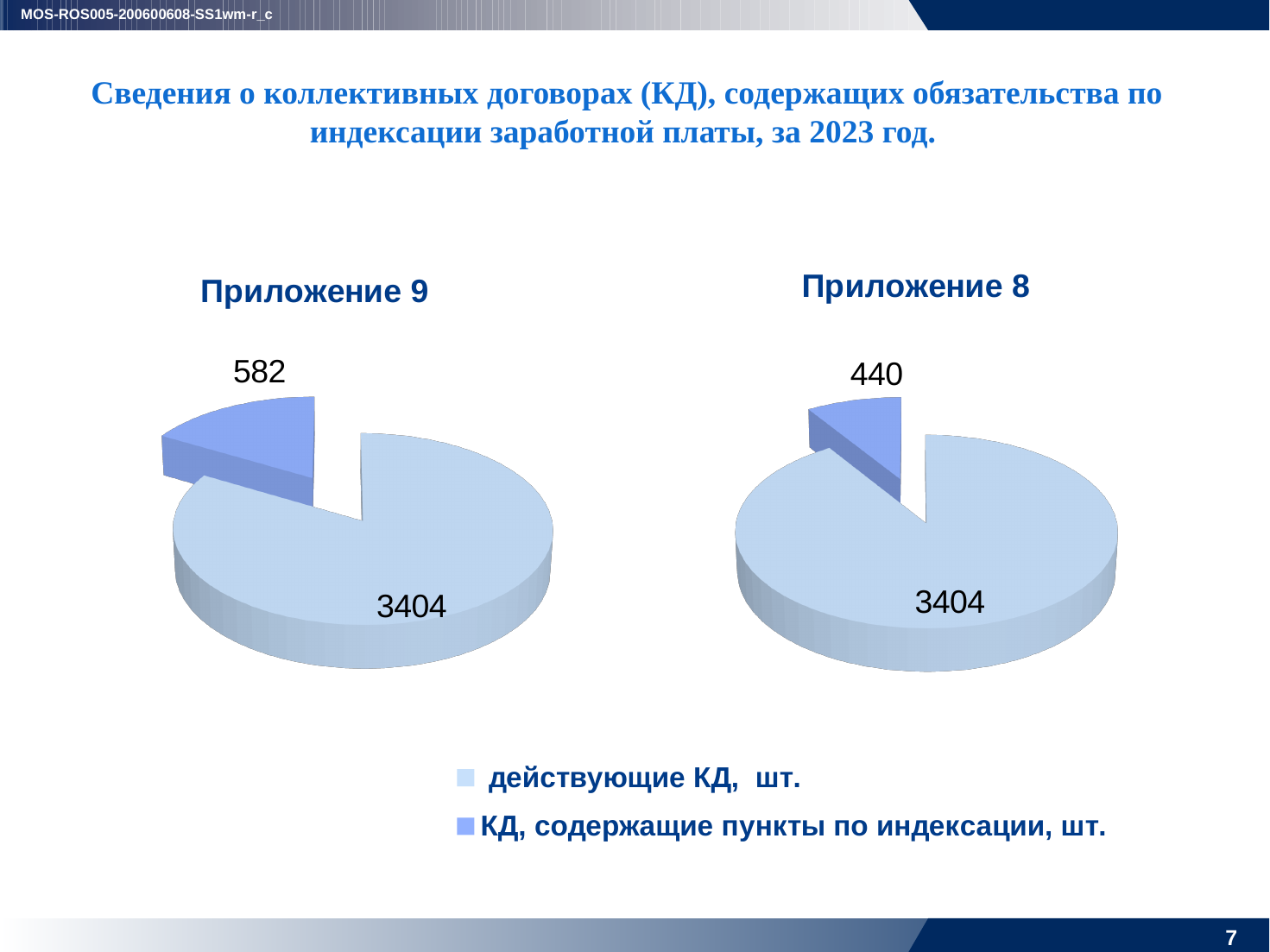
Which chart has the larger value for 'КД, содержащие пункты по индексации, шт.': 'Приложение 9' or 'Приложение 8'? Приложение 9 In the 'Приложение 9' pie chart, which category has the largest slice? действующие КД, шт. In the 'Приложение 9' pie chart, what is the value for 'действующие КД, шт.'? 3404 What type of chart is used for 'Приложение 8'? Pie chart In the 'Приложение 9' pie chart, what is the difference between the two slice values? 2822 In the 'Приложение 8' pie chart, what is the value for 'КД, содержащие пункты по индексации, шт.'? 440 What is the difference between the 'КД, содержащие пункты по индексации, шт.' values in the 'Приложение 9' and 'Приложение 8' charts? 142 In the 'Приложение 8' pie chart, which category has the smallest slice? КД, содержащие пункты по индексации, шт. How many series does the legend list? 2 In the 'Приложение 8' pie chart, what is the value for 'действующие КД, шт.'? 3404 How many slices does the 'Приложение 9' pie chart have? 2 In the 'Приложение 9' pie chart, what is the value for 'КД, содержащие пункты по индексации, шт.'? 582